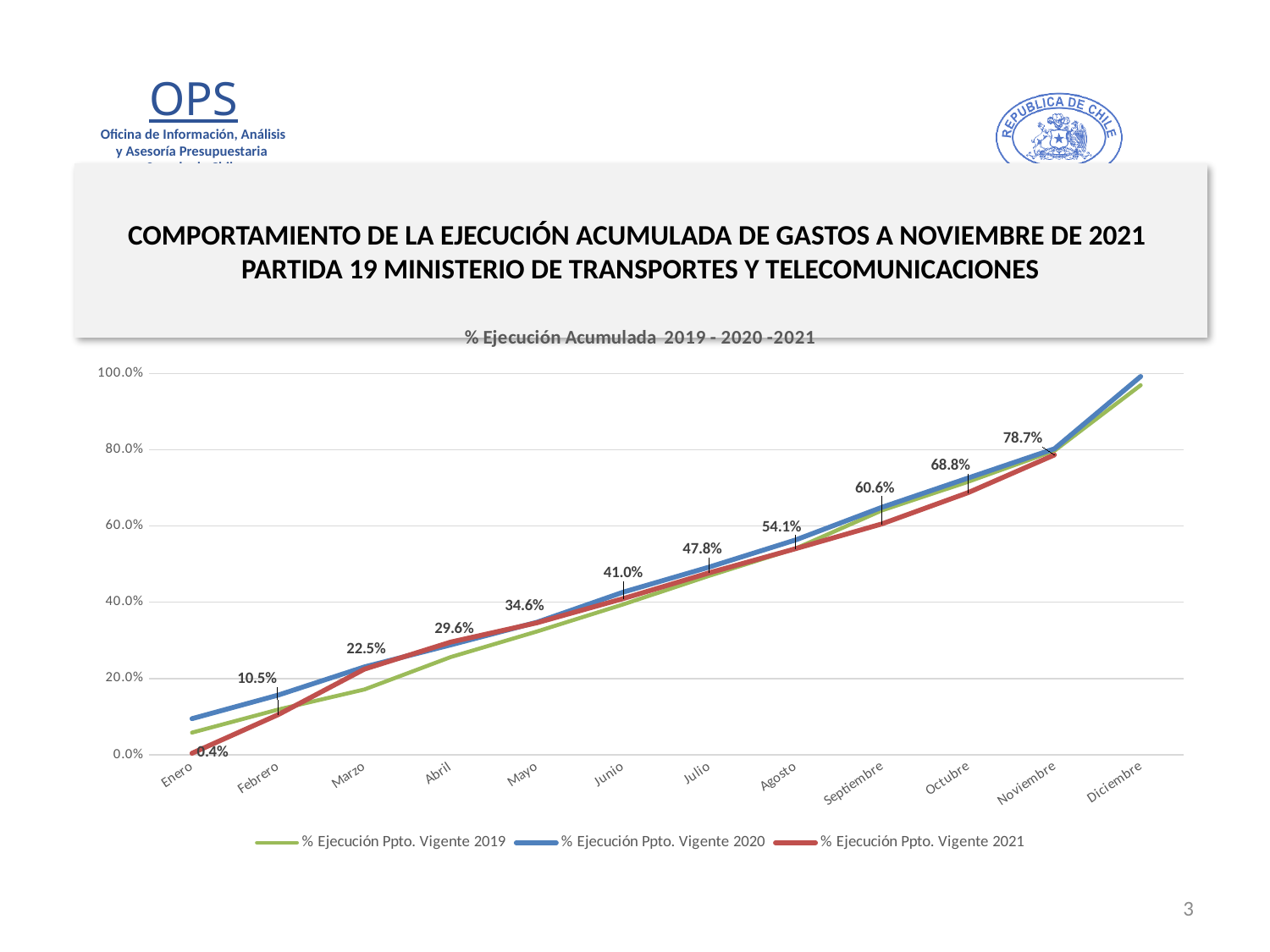
Which month has the highest value for % Ejecución Ppto. Vigente 2021? Noviembre What type of chart is shown on the slide? line chart What is the value for % Ejecución Ppto. Vigente 2021 in Enero? 0.4% Do the values for % Ejecución Ppto. Vigente 2021 rise or fall from Enero to Noviembre? rise What is the value for % Ejecución Ppto. Vigente 2021 in Noviembre? 78.7% How many series does the legend list? 3 What is the difference between the % Ejecución Ppto. Vigente 2021 values for Noviembre and Octubre? 9.9% What is the title of the chart? % Ejecución Acumulada 2019 - 2020 -2021 What is the value for % Ejecución Ppto. Vigente 2021 in Junio? 41.0% Is the value for % Ejecución Ppto. Vigente 2021 in Septiembre greater or less than 60.0%? greater What is the value for % Ejecución Ppto. Vigente 2021 in Agosto? 54.1% Which month has the lowest value for % Ejecución Ppto. Vigente 2021? Enero